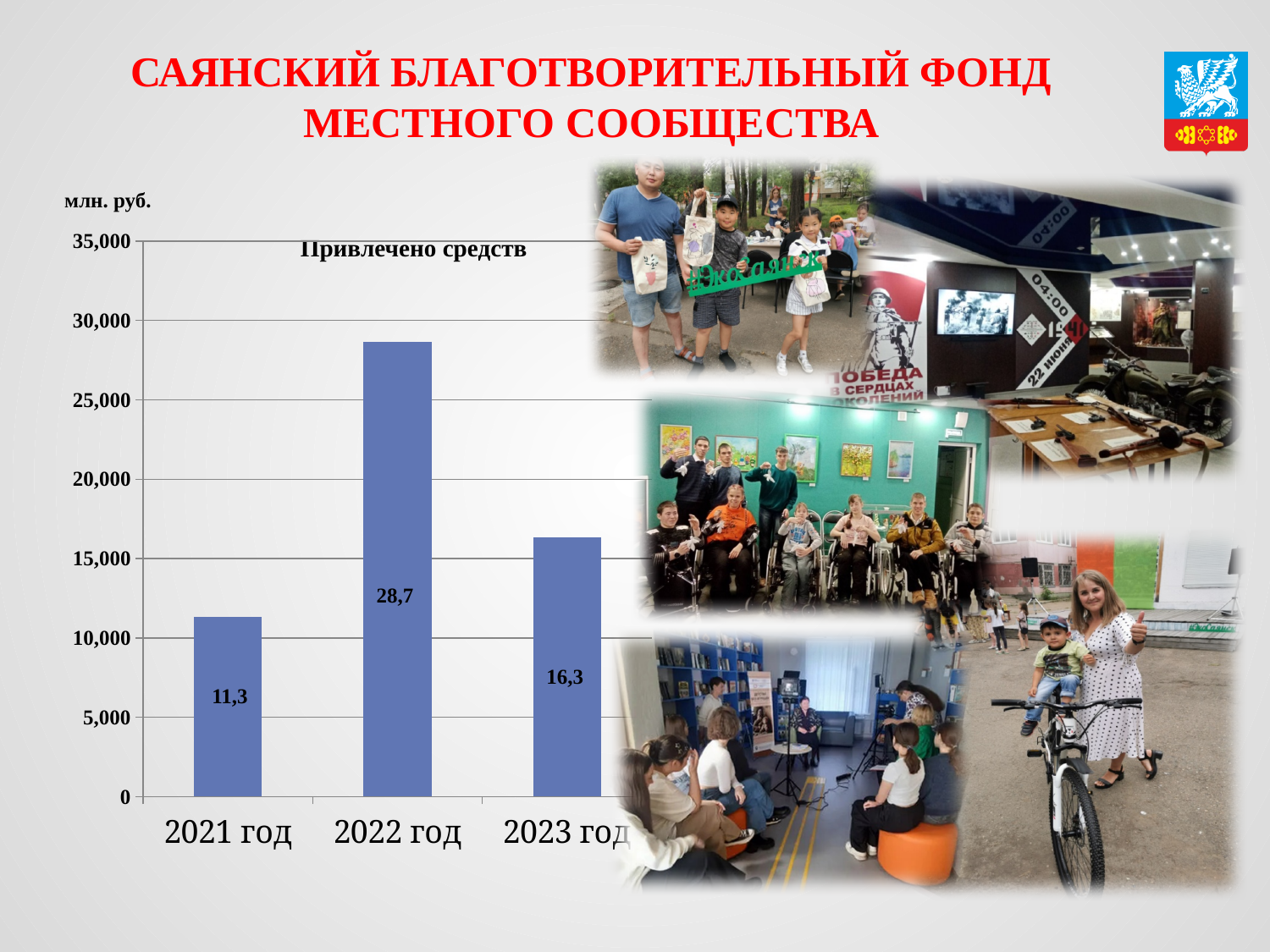
How many years are shown on the x axis of the chart? 3 Is the bar for 2022 год greater or less than the 25,000 axis tick? greater Which is larger, the value for 2023 год or the value for 2021 год? 2023 год Which year has the lowest value in the chart? 2021 год What is the title of the chart? Привлечено средств What kind of chart is shown on the slide? bar chart What is the difference between the values for 2022 год and 2021 год? 17,4 What is the value for 2022 год in the chart? 28,7 What is the value for 2021 год in the chart? 11,3 Which year has the highest value in the chart? 2022 год What is the value for 2023 год in the chart? 16,3 What is the difference between the values for 2022 год and 2023 год? 12,4